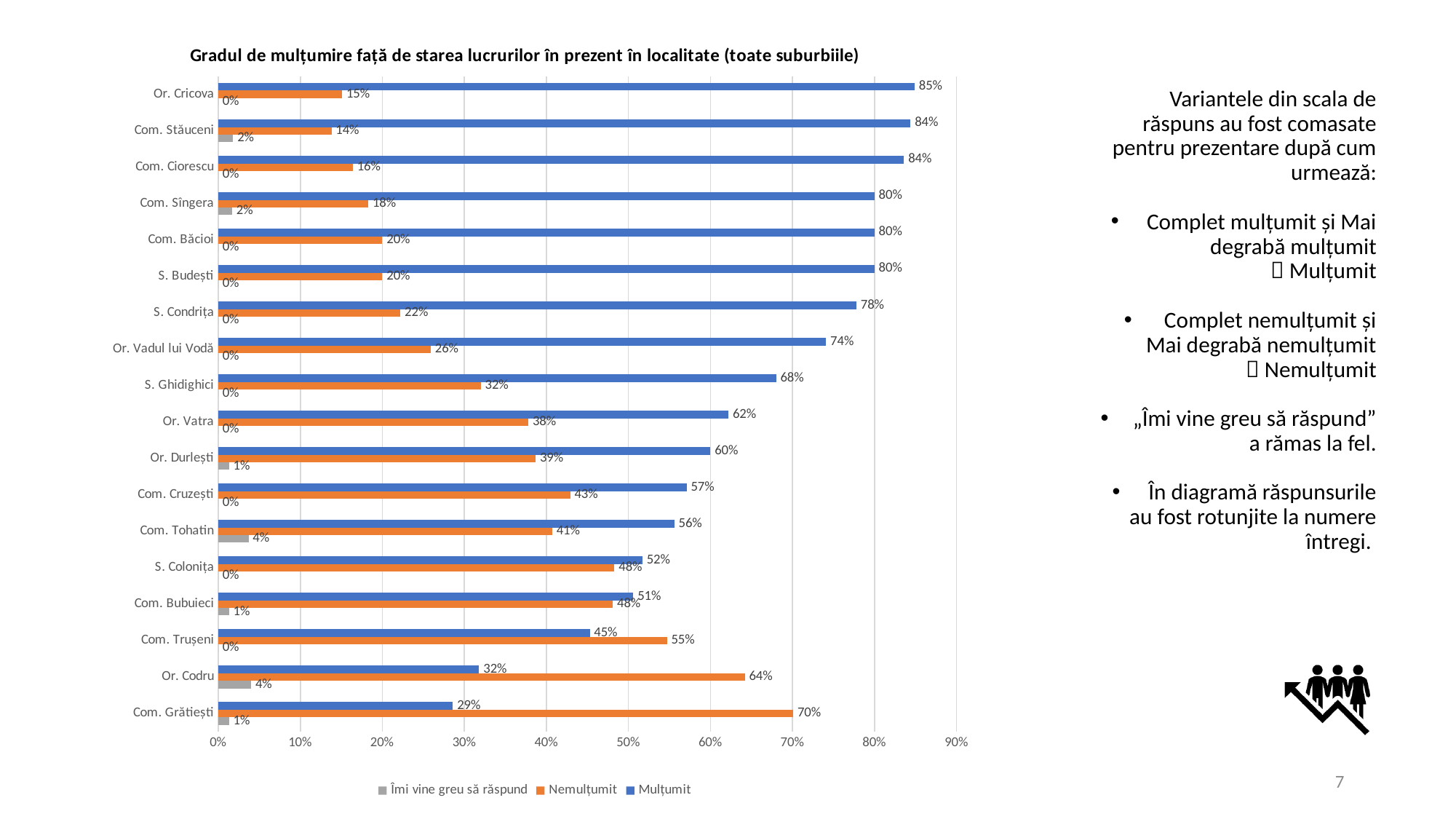
What kind of chart is shown on the slide? Bar chart Which locality has the lowest Mulțumit value? Com. Grătiești Which locality has the highest Nemulțumit value? Com. Grătiești How many localities are shown on the chart? 18 Which colour represents the Nemulțumit series? Orange Which is larger for Com. Trușeni: the Mulțumit value or the Nemulțumit value? Nemulțumit What is the difference between the Mulțumit and Nemulțumit values for Or. Codru? 32% What is the Îmi vine greu să răspund value for Com. Tohatin? 4% Which locality has the highest Mulțumit value? Or. Cricova How many series does the legend list? 3 What is the Nemulțumit value for Com. Cruzești? 43% What is the Mulțumit value for Or. Vadul lui Vodă? 74%